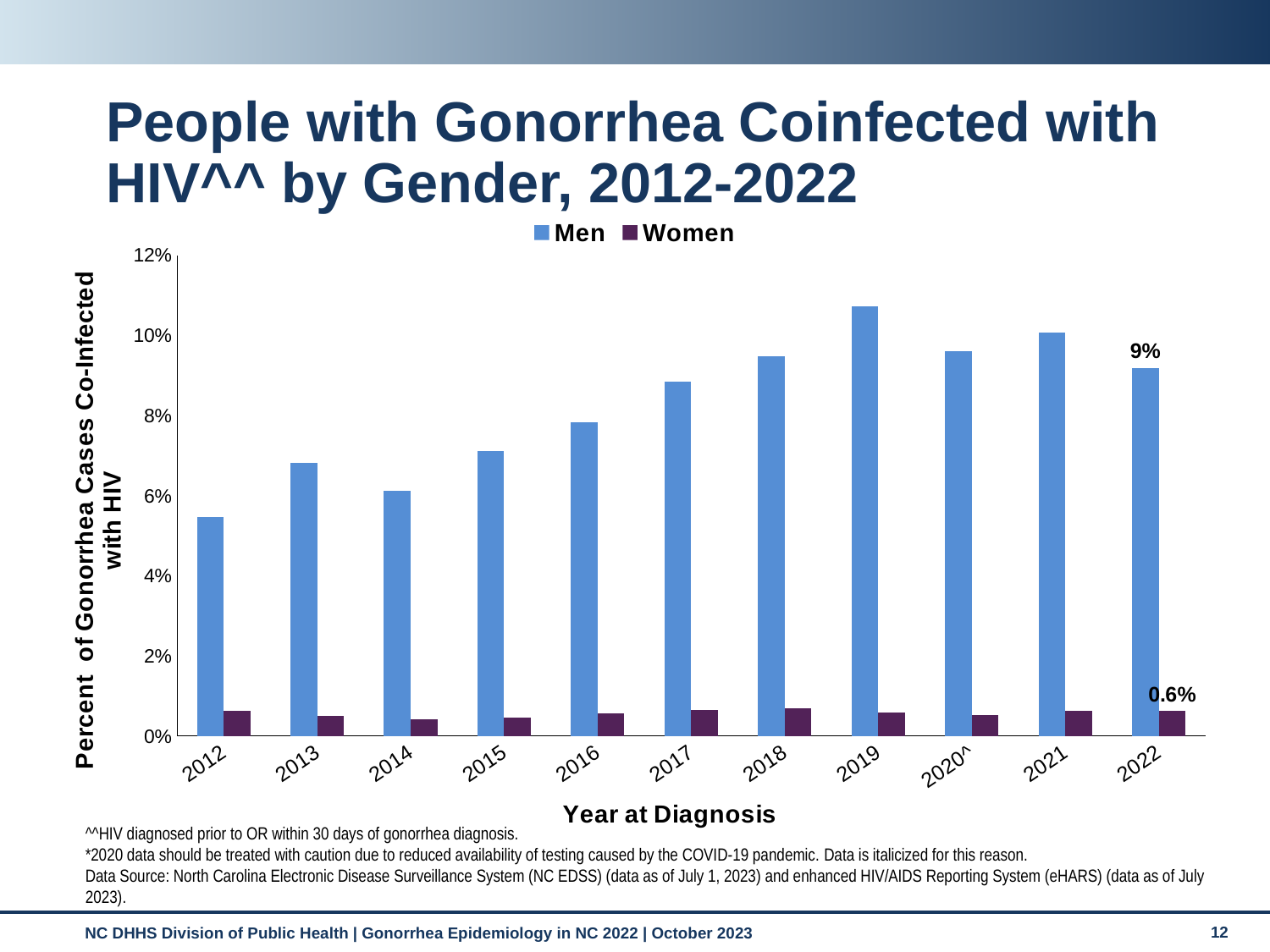
How many series does the legend list? 2 How many years are shown on the x axis of the chart? 11 In which year was the percentage of men co-infected with HIV the lowest? 2012 Which is larger, the Men value in 2019 or the Men value in 2012? 2019 What percentage of women with gonorrhea were co-infected with HIV in 2022? 0.6% What kind of chart is shown on the slide? Bar chart Is the value for Men in 2012 greater or less than 6%? less Did the percentage of men co-infected with HIV generally rise or fall from 2012 to 2019? Rise In 2022, how many percentage points higher is the Men value than the Women value? 8.4% In which year was the percentage of men co-infected with HIV the highest? 2019 What percentage of men with gonorrhea were co-infected with HIV in 2022? 9% Is the value for Men in 2018 greater or less than 8%? greater